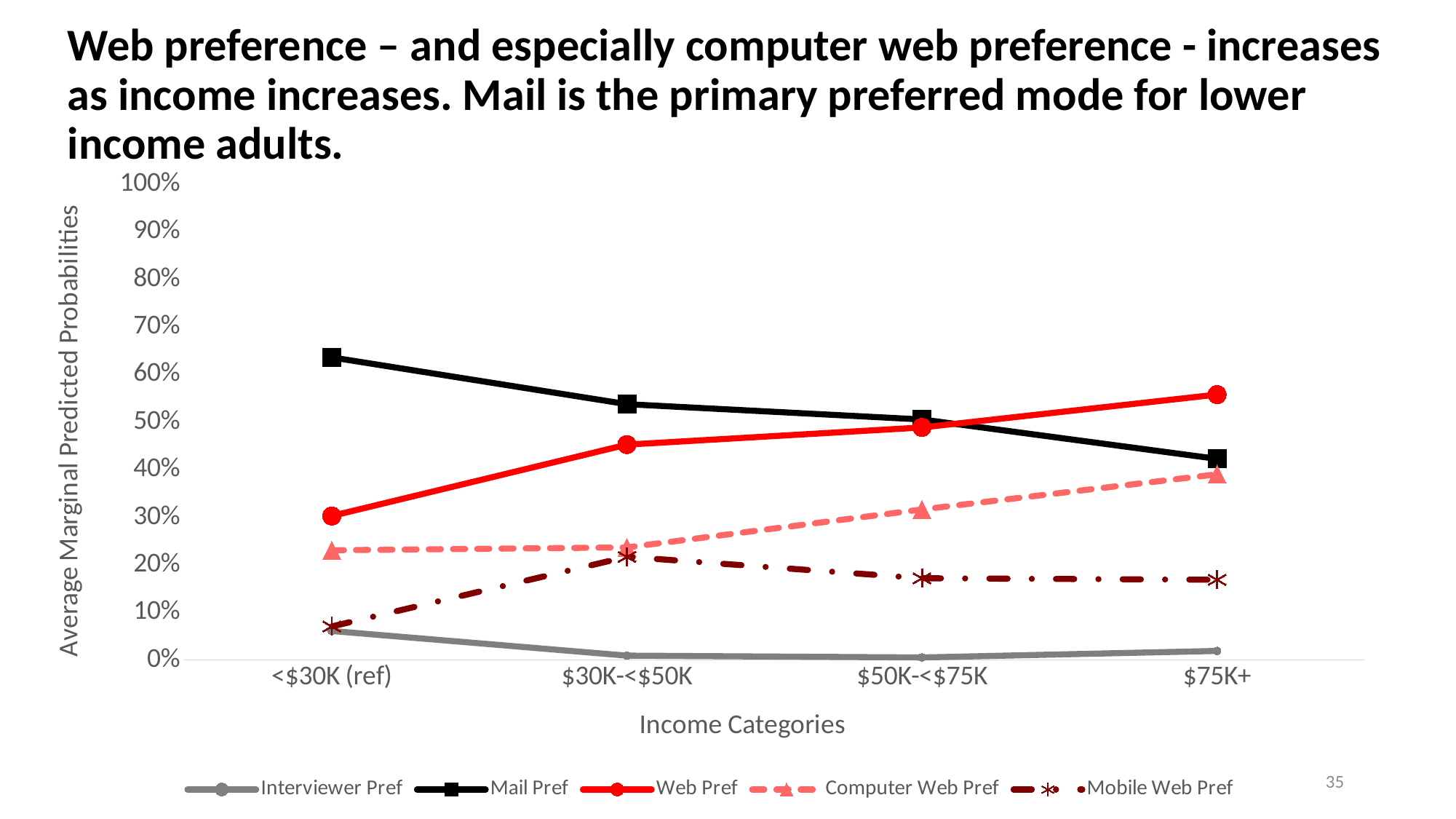
What kind of chart is shown on the slide? line chart Which series has the lowest value at $75K+? Interviewer Pref How many series does the legend list? 5 Which series has the highest value at <$30K (ref)? Mail Pref How many income categories are shown on the x axis? 4 Is the value for Web Pref at <$30K (ref) greater or less than 40%? less At $30K-<$50K, which is larger: Mail Pref or Web Pref? Mail Pref Does the Mail Pref line rise or fall as income increases along the x axis? falls Is the value for Mail Pref at <$30K (ref) greater or less than 60%? greater What is the title of the x axis? Income Categories Which series has the highest value at $75K+? Web Pref Does the Web Pref line rise or fall as income increases along the x axis? rises